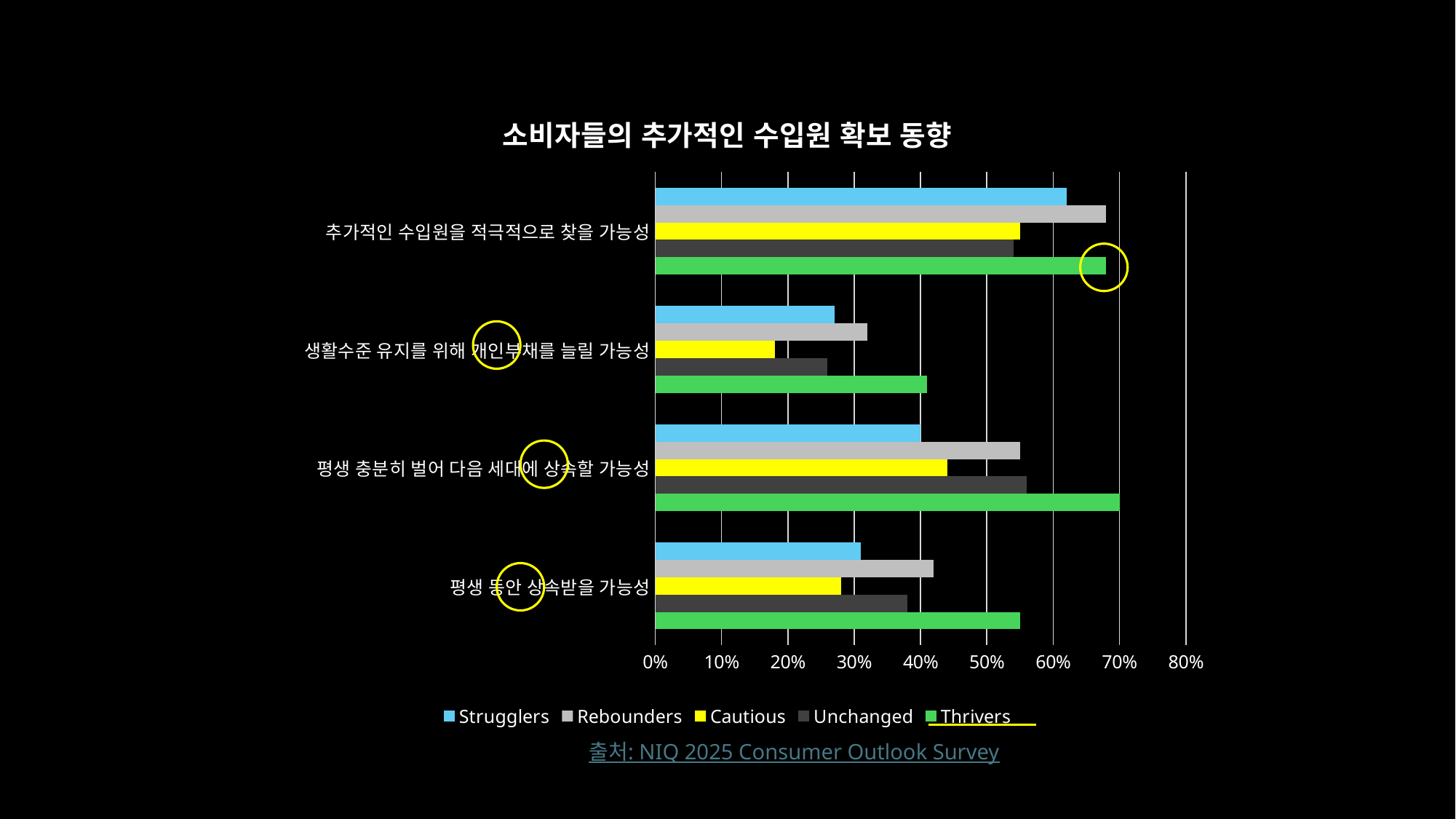
Is the Cautious value for 생활수준 유지를 위해 개인부채를 늘릴 가능성 greater or less than 20%? less Which series has the lowest value for 생활수준 유지를 위해 개인부채를 늘릴 가능성? Cautious Which series is shown in green in the legend? Thrivers Is the Strugglers value for 생활수준 유지를 위해 개인부채를 늘릴 가능성 greater or less than 30%? less Is the Rebounders value for 평생 동안 상속받을 가능성 greater or less than 40%? greater What is the title of the chart? 소비자들의 추가적인 수입원 확보 동향 How many series does the legend list? 5 How many categories are plotted on the chart? 4 Which series has the highest value for 평생 충분히 벌어 다음 세대에 상속할 가능성? Thrivers What kind of chart is shown on the slide? Bar chart For 추가적인 수입원을 적극적으로 찾을 가능성, which is larger: the Rebounders value or the Cautious value? Rebounders